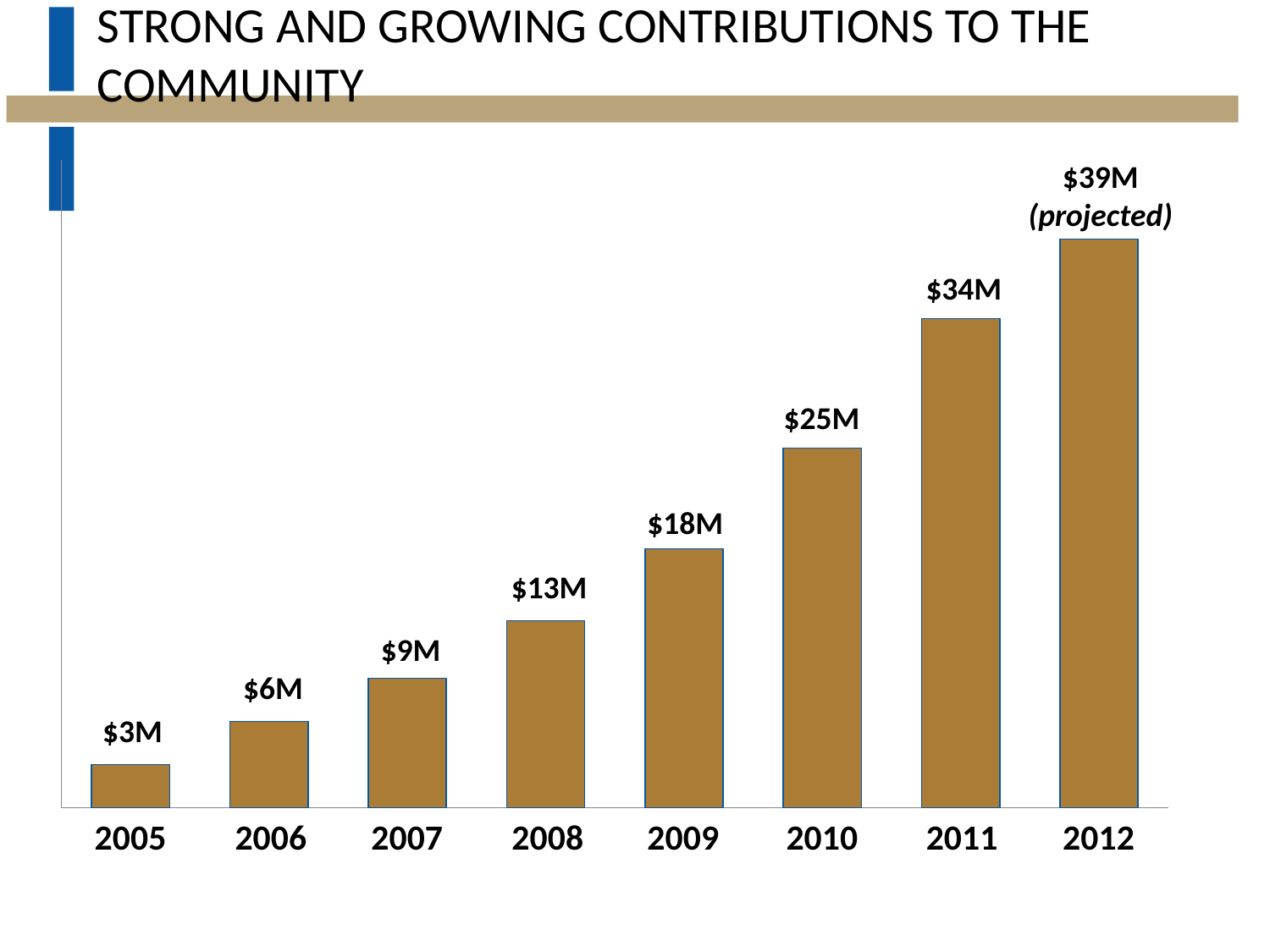
What is the value for 2011? $34M What is the difference between the values for 2010 and 2008? $12M Which year's value is labelled as projected? 2012 What is the value for 2005? $3M What is the value for 2009? $18M What is the difference between the values for 2012 and 2011? $5M How many years are shown on the x axis? 8 What kind of chart is this? bar chart Which year has the highest value? 2012 Which year has the lowest value? 2005 Which is larger, the value for 2007 or the value for 2006? 2007 Do the values rise or fall from 2005 to 2012? rise